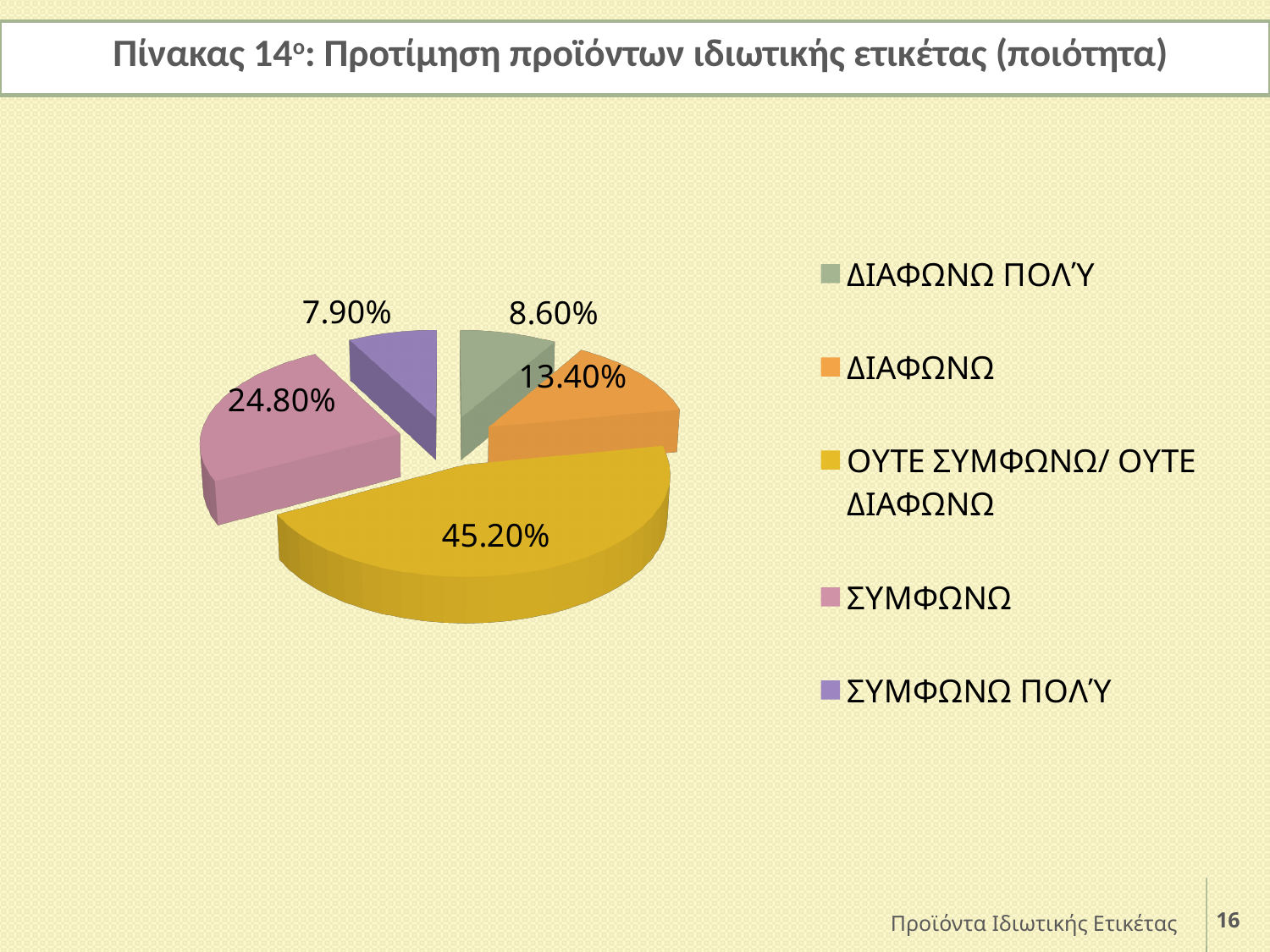
Which is larger, the slice for ΔΙΑΦΩΝΩ or the slice for ΣΥΜΦΩΝΩ ΠΟΛΎ? ΔΙΑΦΩΝΩ What percentage is shown for ΣΥΜΦΩΝΩ ΠΟΛΎ? 7.90% What colour is the slice for ΣΥΜΦΩΝΩ? Pink What percentage is shown for ΟΥΤΕ ΣΥΜΦΩΝΩ/ ΟΥΤΕ ΔΙΑΦΩΝΩ? 45.20% How many categories does the legend list? 5 What percentage is shown for ΔΙΑΦΩΝΩ ΠΟΛΎ? 8.60% Which category has the smallest slice of the pie? ΣΥΜΦΩΝΩ ΠΟΛΎ What percentage is shown for ΣΥΜΦΩΝΩ? 24.80% What kind of chart is shown on the slide? Pie chart What percentage is shown for ΔΙΑΦΩΝΩ? 13.40% Which category has the largest slice of the pie? ΟΥΤΕ ΣΥΜΦΩΝΩ/ ΟΥΤΕ ΔΙΑΦΩΝΩ What is the difference in percentage points between ΣΥΜΦΩΝΩ and ΔΙΑΦΩΝΩ? 11.40%